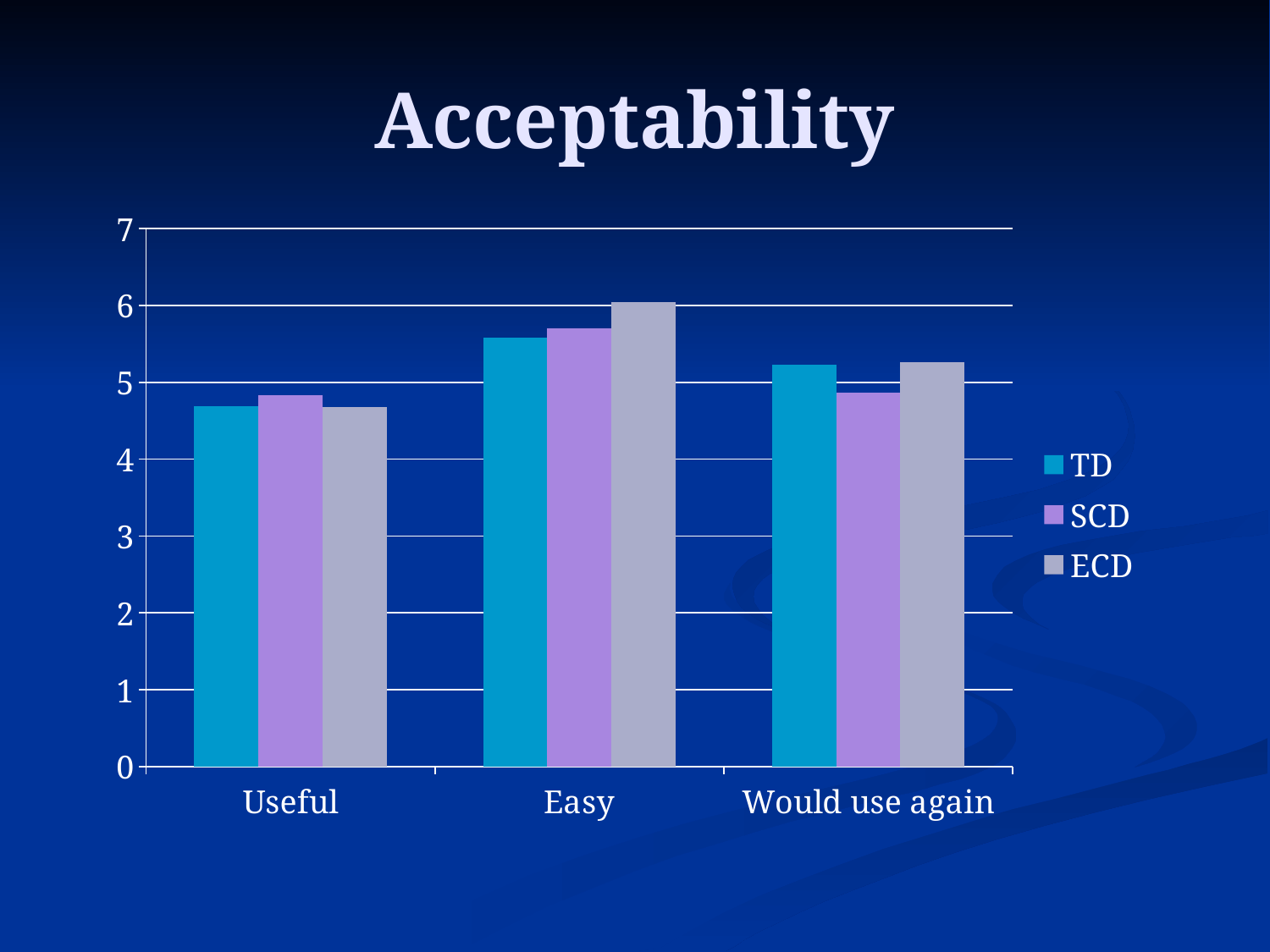
Is the TD value for Useful greater or less than 5? less Which series has the lowest value for Would use again? SCD How many series does the legend list? 3 Which series has the highest value for Easy? ECD What is the title of the chart? Acceptability Which series is shown in purple in the legend? SCD Is the SCD value for Would use again greater or less than 5? less Is the ECD value for Useful greater or less than 5? less For the TD series, which is larger: the value for Useful or the value for Easy? Easy What kind of chart is shown on the slide? bar chart How many categories are shown on the x axis? 3